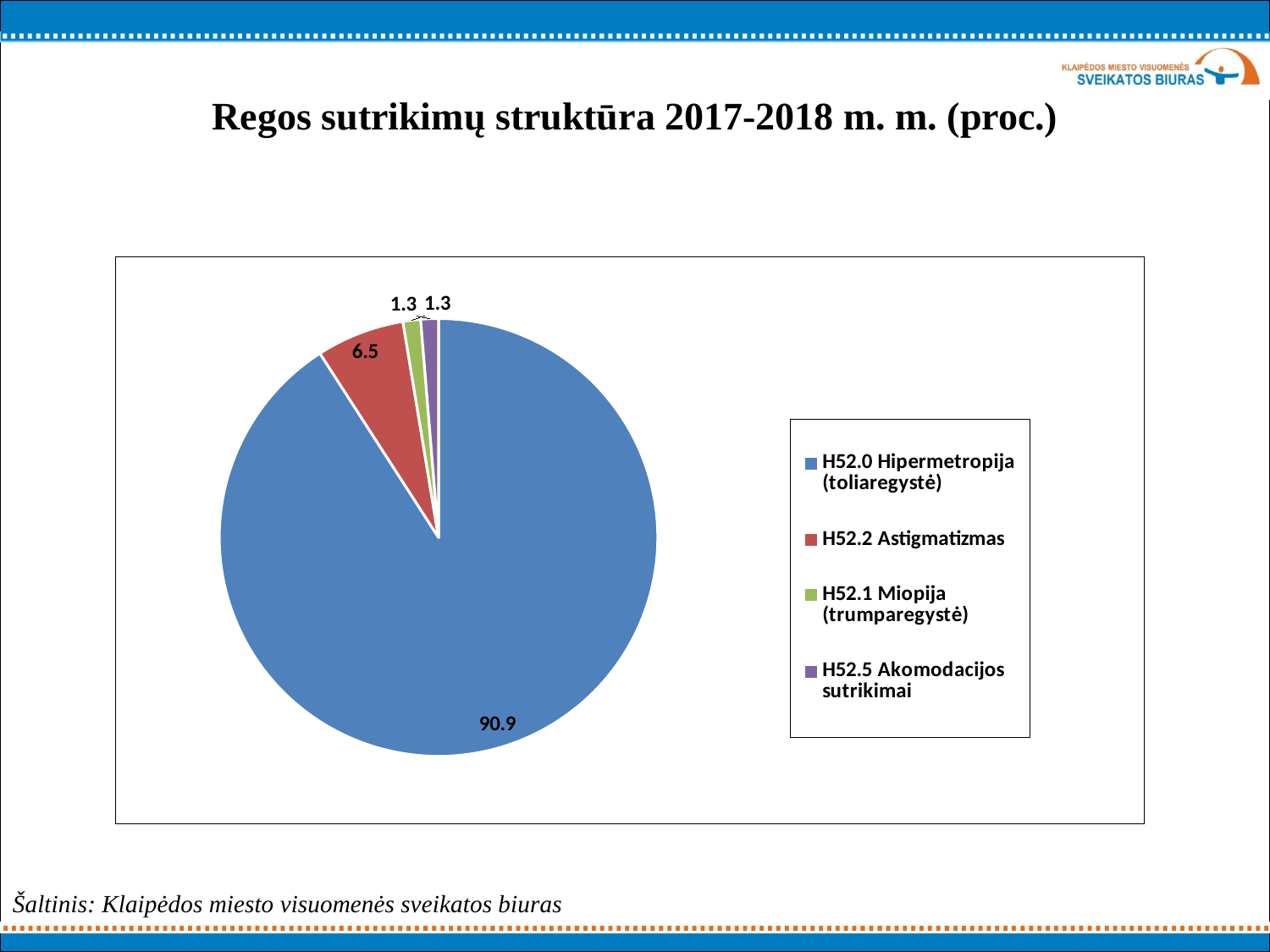
What type of chart is shown on the slide? pie chart Which category has the largest slice of the pie? H52.0 Hipermetropija (toliaregystė) What is the title of the chart on the slide? Regos sutrikimų struktūra 2017-2018 m. m. (proc.) What is the value for H52.1 Miopija (trumparegystė)? 1.3 What is the value for H52.2 Astigmatizmas? 6.5 What is the difference between the values for H52.0 Hipermetropija (toliaregystė) and H52.2 Astigmatizmas? 84.4 How many entries does the legend list? 4 Which is larger, the value for H52.2 Astigmatizmas or the value for H52.5 Akomodacijos sutrikimai? H52.2 Astigmatizmas What is the difference between the values for H52.2 Astigmatizmas and H52.1 Miopija (trumparegystė)? 5.2 What is the value for H52.0 Hipermetropija (toliaregystė)? 90.9 What is the value for H52.5 Akomodacijos sutrikimai? 1.3 How many slices does the pie chart have? 4